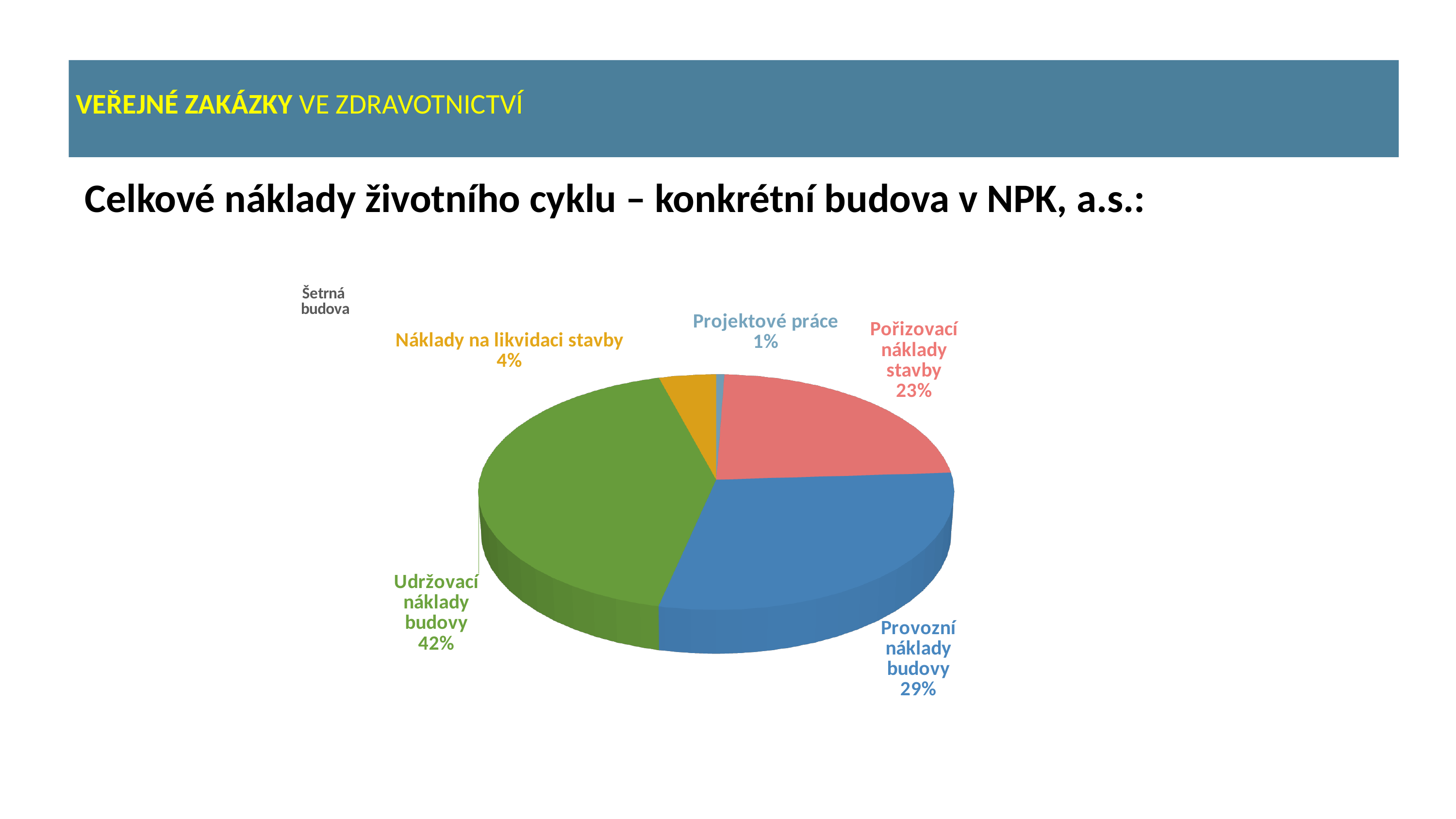
What is the difference in percentage points between Udržovací náklady budovy and Provozní náklady budovy? 13 What kind of chart is shown on the slide? Pie chart What share of the pie does Udržovací náklady budovy represent? 42% What is the title of the chart? Šetrná budova Which is larger: Pořizovací náklady stavby or Provozní náklady budovy? Provozní náklady budovy How many categories are shown in the pie chart? 5 Which category has the smallest slice of the pie? Projektové práce Which category has the largest slice of the pie? Udržovací náklady budovy What share of the pie does Provozní náklady budovy represent? 29% What share of the pie does Pořizovací náklady stavby represent? 23%